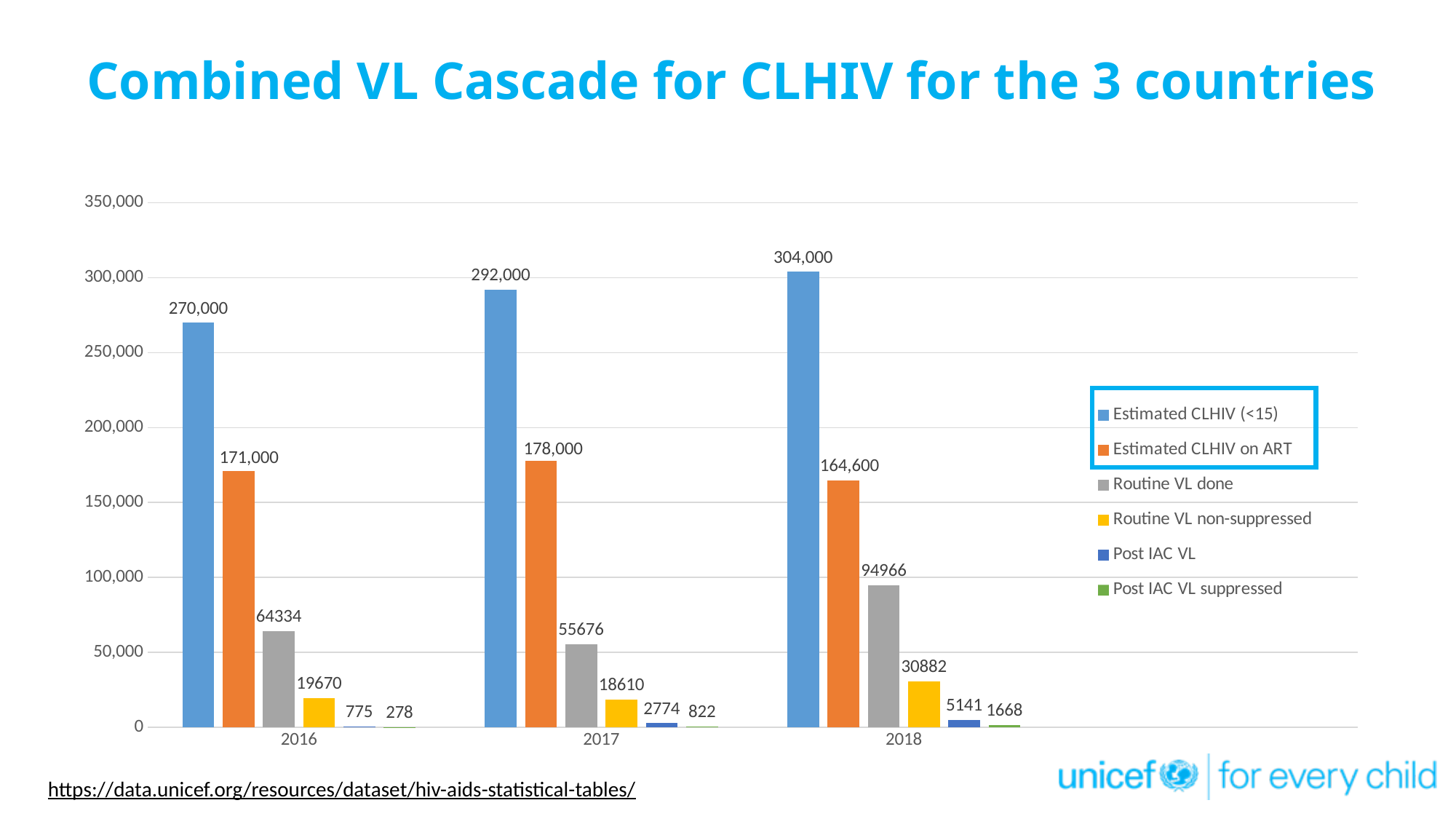
What is the value for Routine VL done in 2017? 55676 How many series does the legend list? 6 What is the value for Estimated CLHIV on ART in 2016? 171,000 In which year is Routine VL non-suppressed lowest? 2017 What kind of chart is shown on the slide? bar chart What is the difference between Estimated CLHIV (<15) in 2017 and 2016? 22,000 What is the value for Post IAC VL suppressed in 2018? 1668 How many years are shown on the x axis? 3 What is the value for Estimated CLHIV (<15) in 2018? 304,000 In which year is Estimated CLHIV (<15) highest? 2018 Is the value for Routine VL done in 2018 greater or less than 100,000? less Which is larger: Estimated CLHIV on ART in 2017 or in 2018? 2017